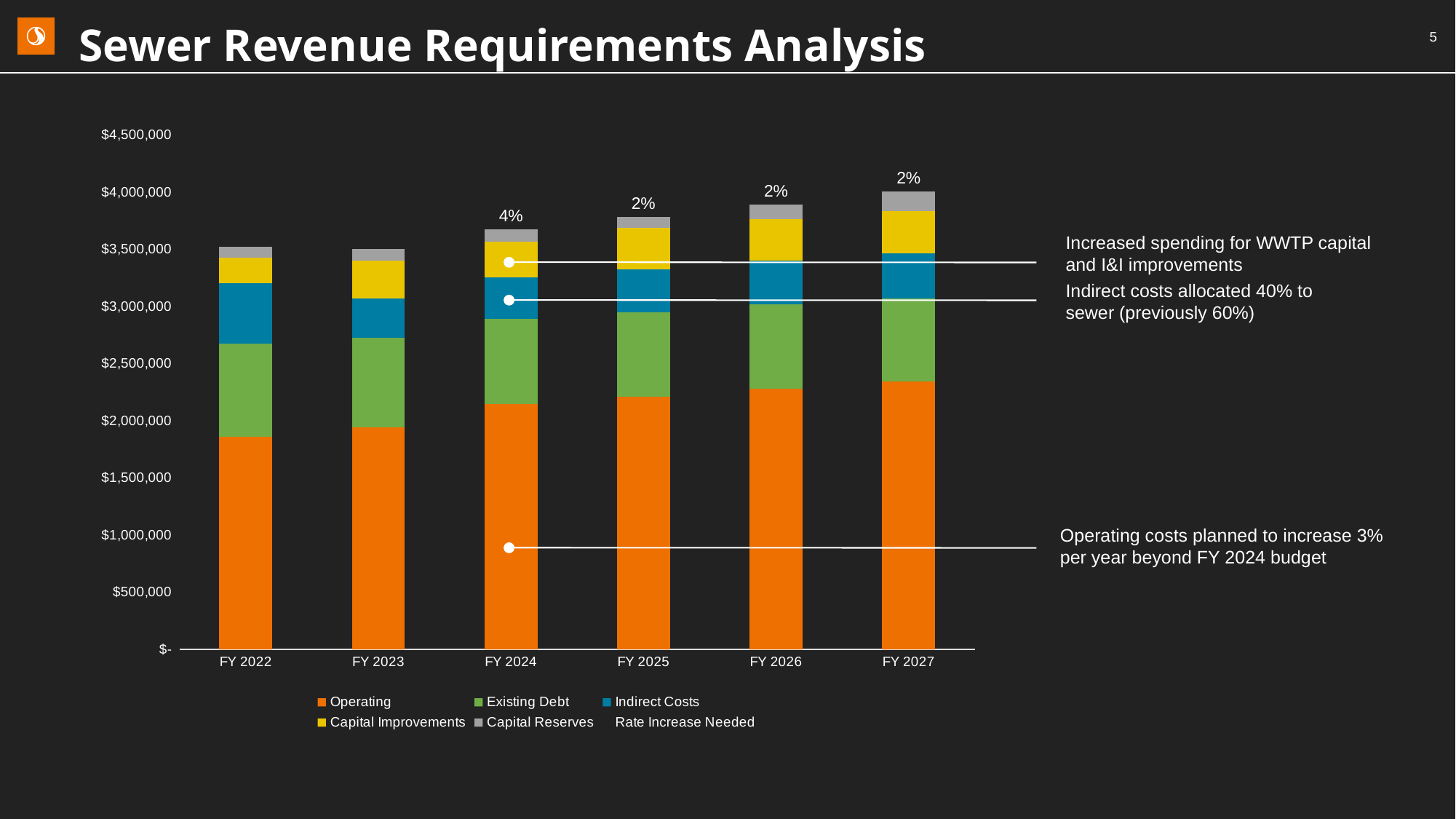
Which is larger, the Operating segment for FY 2022 or for FY 2027? FY 2027 What rate increase is labelled for FY 2026? 2% Is the Operating value for FY 2027 greater or less than $2,000,000? greater What kind of chart is shown on the slide? bar chart What rate increase is labelled for FY 2024? 4% How many fiscal years are shown on the x axis of the chart? 6 Is the Operating value for FY 2022 greater or less than $2,000,000? less Which fiscal year has the tallest total stacked bar? FY 2027 How many series does the chart legend list? 6 Which series is shown in orange in the chart? Operating Which fiscal year has the highest labelled rate increase needed? FY 2024 Is the total stacked bar for FY 2025 greater or less than $4,000,000? less